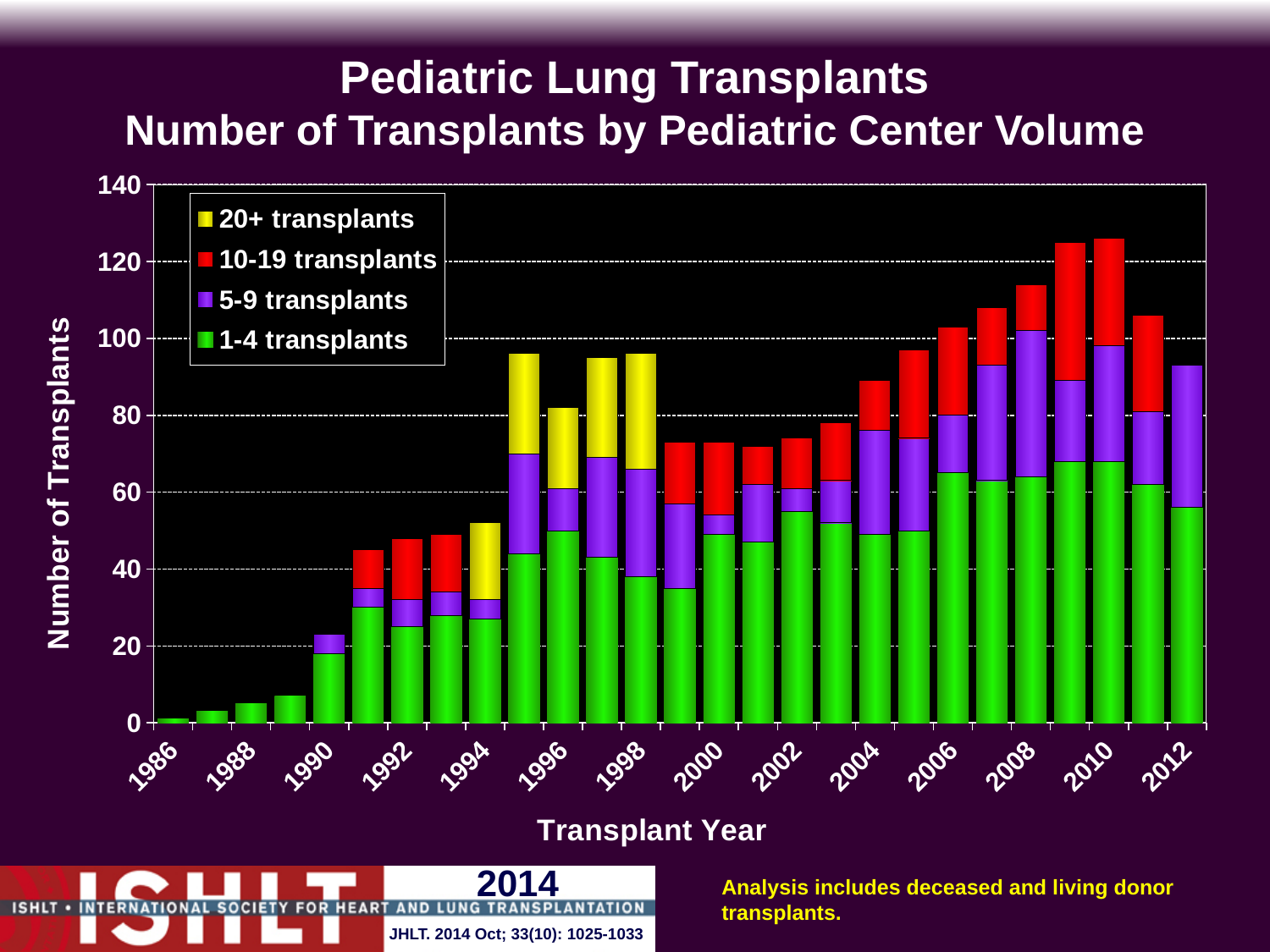
Which year has a larger total number of transplants, 2008 or 2004? 2008 Is the total number of transplants for 2012 greater or less than 100? less Which year has a larger total number of transplants, 1990 or 1995? 1995 How many series does the legend list? 4 Do the total number of transplants rise or fall from 1986 to 1990? rise Which transplant year has the lowest total number of transplants? 1986 What kind of chart is shown on the slide? Stacked bar chart Which colour represents the '20+ transplants' series in the legend? Yellow Is the total number of transplants for 2010 greater or less than 120? greater Is the total number of transplants for 2000 greater or less than 60? greater How many transplant years (bars) are plotted on the x axis? 27